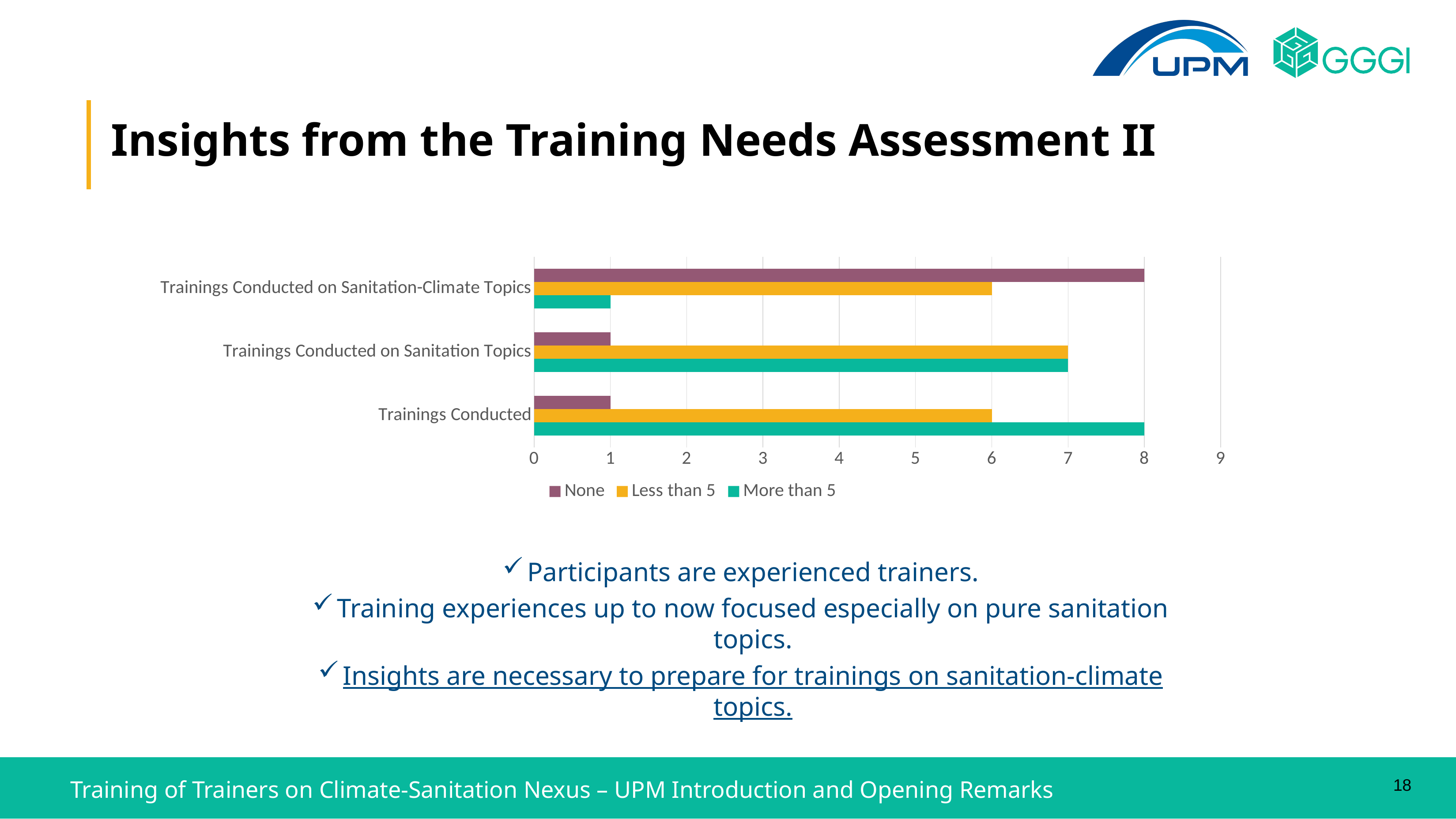
What is the value of 'More than 5' for Trainings Conducted? 8 Which legend entry is shown in orange? Less than 5 What is the value of 'None' for Trainings Conducted on Sanitation-Climate Topics? 8 Which category has the lowest value for 'More than 5'? Trainings Conducted on Sanitation-Climate Topics What kind of chart is shown on the slide? bar chart How many series does the legend list? 3 What is the value of 'More than 5' for Trainings Conducted on Sanitation-Climate Topics? 1 Which category has the highest value for 'None'? Trainings Conducted on Sanitation-Climate Topics How many categories are shown on the chart? 3 Which is larger for Trainings Conducted: 'Less than 5' or 'More than 5'? More than 5 What is the difference between 'None' and 'More than 5' for Trainings Conducted on Sanitation-Climate Topics? 7 What is the value of 'Less than 5' for Trainings Conducted on Sanitation Topics? 7